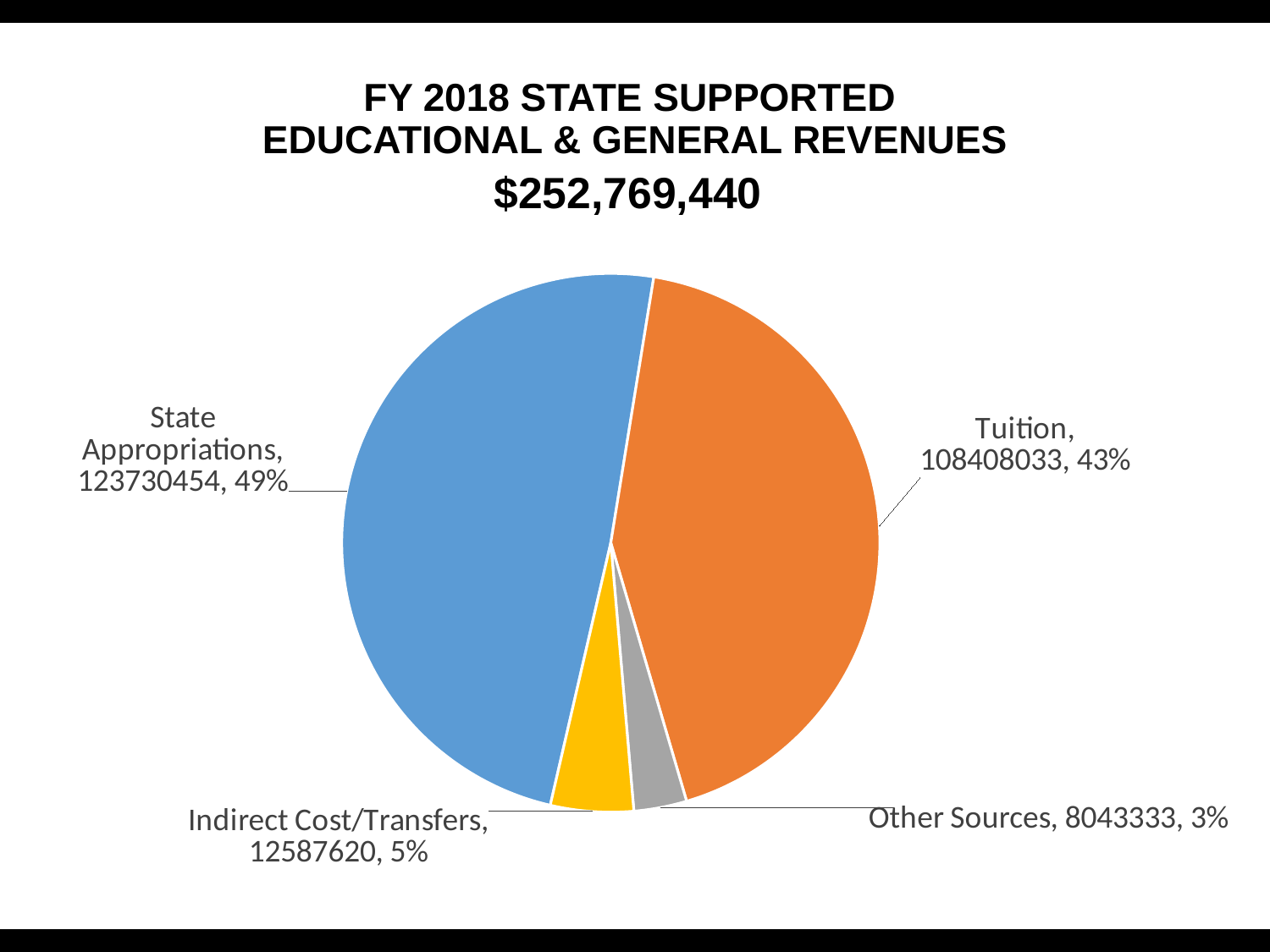
Which category has the largest slice? State Appropriations What is the value for Tuition? 108408033 Which category has the smallest slice? Other Sources What share of the pie does Tuition represent? 43% What total amount is shown in the chart title? $252,769,440 What kind of chart is shown on the slide? pie chart What is the value for Other Sources? 8043333 How many slices does the pie chart have? 4 What is the value for Indirect Cost/Transfers? 12587620 What is the difference between the values for State Appropriations and Tuition? 15322421 What share of the pie does Indirect Cost/Transfers represent? 5% What is the value for State Appropriations? 123730454